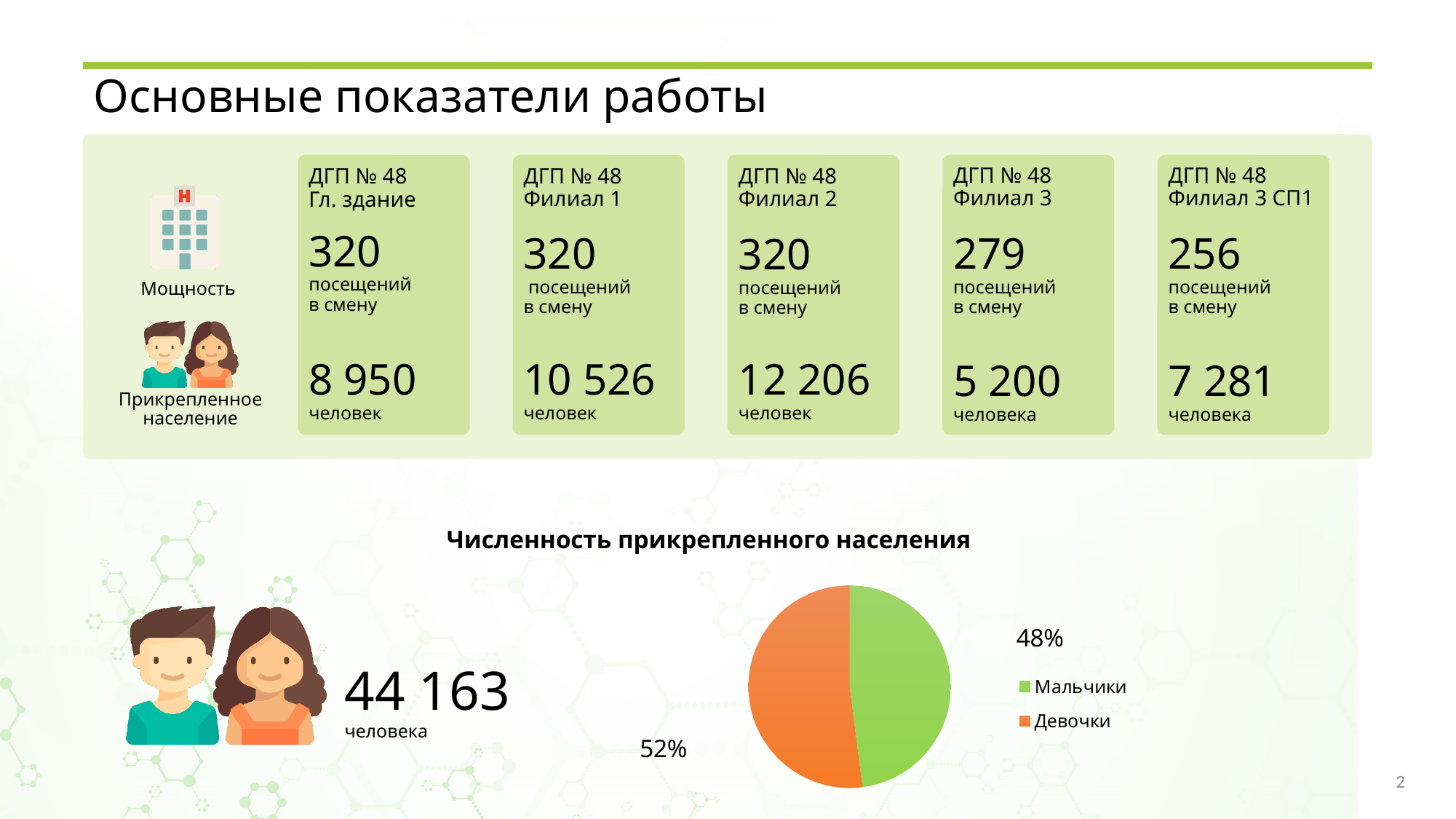
What is the title of the pie chart? Численность прикрепленного населения Which slice of the pie chart is the largest? Девочки How many slices does the pie chart have? 2 What share of the pie chart does "Мальчики" represent? 48% Is the share for "Мальчики" in the pie chart greater or less than 50%? less How many entries does the pie chart legend list? 2 What share of the pie chart does "Девочки" represent? 52% What is the difference in percentage points between the "Девочки" and "Мальчики" slices? 4% What colour is the "Девочки" slice in the pie chart? orange Which is larger in the pie chart, "Мальчики" or "Девочки"? Девочки What kind of chart is shown under the title "Численность прикрепленного населения"? pie chart Which slice of the pie chart is the smallest? Мальчики